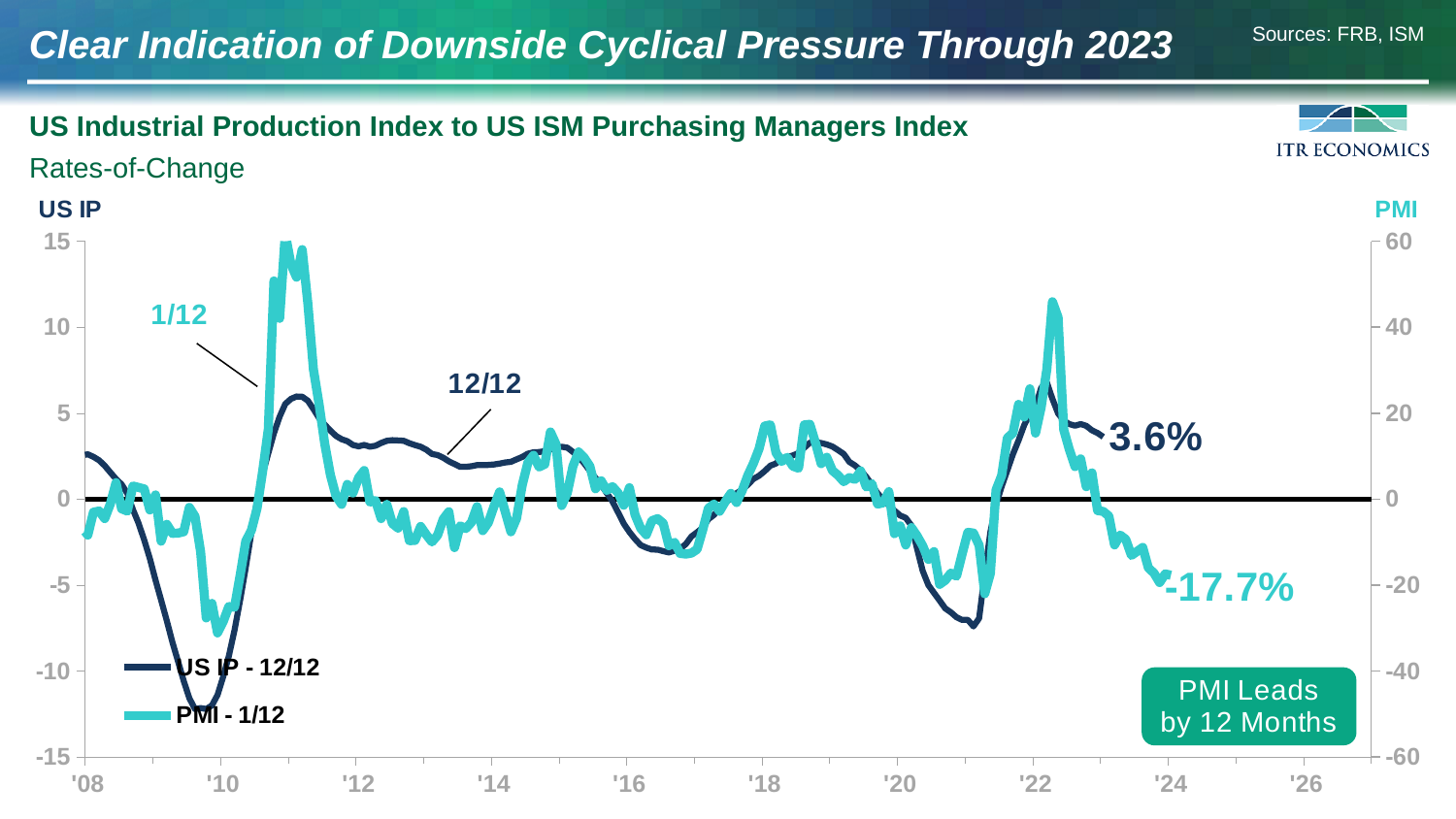
Is the latest labeled value of the PMI - 1/12 series greater or less than 0? less What does the green callout box on the chart say? PMI Leads by 12 Months Is the peak value of the PMI - 1/12 series around 2011 greater or less than 40 on the PMI axis? greater What is the latest labeled value for the PMI - 1/12 series? -17.7% Is the lowest value of the US IP - 12/12 series around 2009 greater or less than -10 on the US IP axis? less What is the title of the chart? US Industrial Production Index to US ISM Purchasing Managers Index Which series has the higher latest labeled value, US IP - 12/12 or PMI - 1/12? US IP - 12/12 How many year labels are shown on the x axis? 10 What kind of chart is shown on the slide? line chart How many series does the legend list? 2 Does the PMI - 1/12 series rise or fall from its 2022 peak to the end of the plotted data? fall What is the latest labeled value for the US IP - 12/12 series? 3.6%